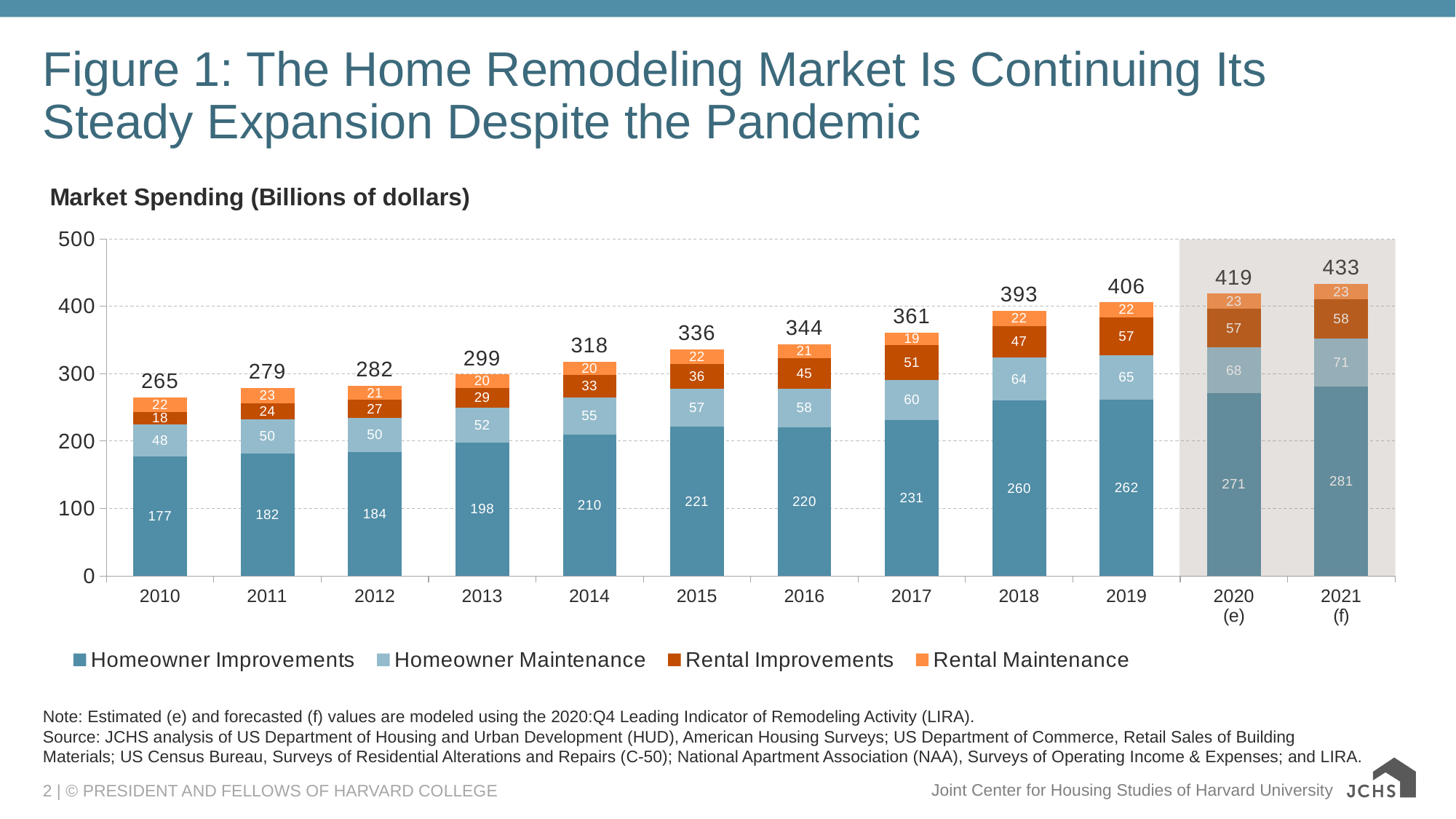
What is the Rental Improvements value for 2017? 51 What is the title of the chart's y-axis measure shown above the plot? Market Spending (Billions of dollars) What is the total market spending shown for 2021 (f)? 433 How many series does the legend list? 4 Which year has the highest total market spending? 2021 (f) How many years (categories) are shown on the x axis? 12 Which year has the lowest total market spending? 2010 Do the total values rise or fall from 2010 to 2021? Rise What kind of chart is shown on the slide? Stacked bar chart What is the difference between the total for 2019 and the total for 2010? 141 What is the Homeowner Improvements value for 2018? 260 Which is larger, Homeowner Maintenance in 2020 (e) or Rental Improvements in 2020 (e)? Homeowner Maintenance